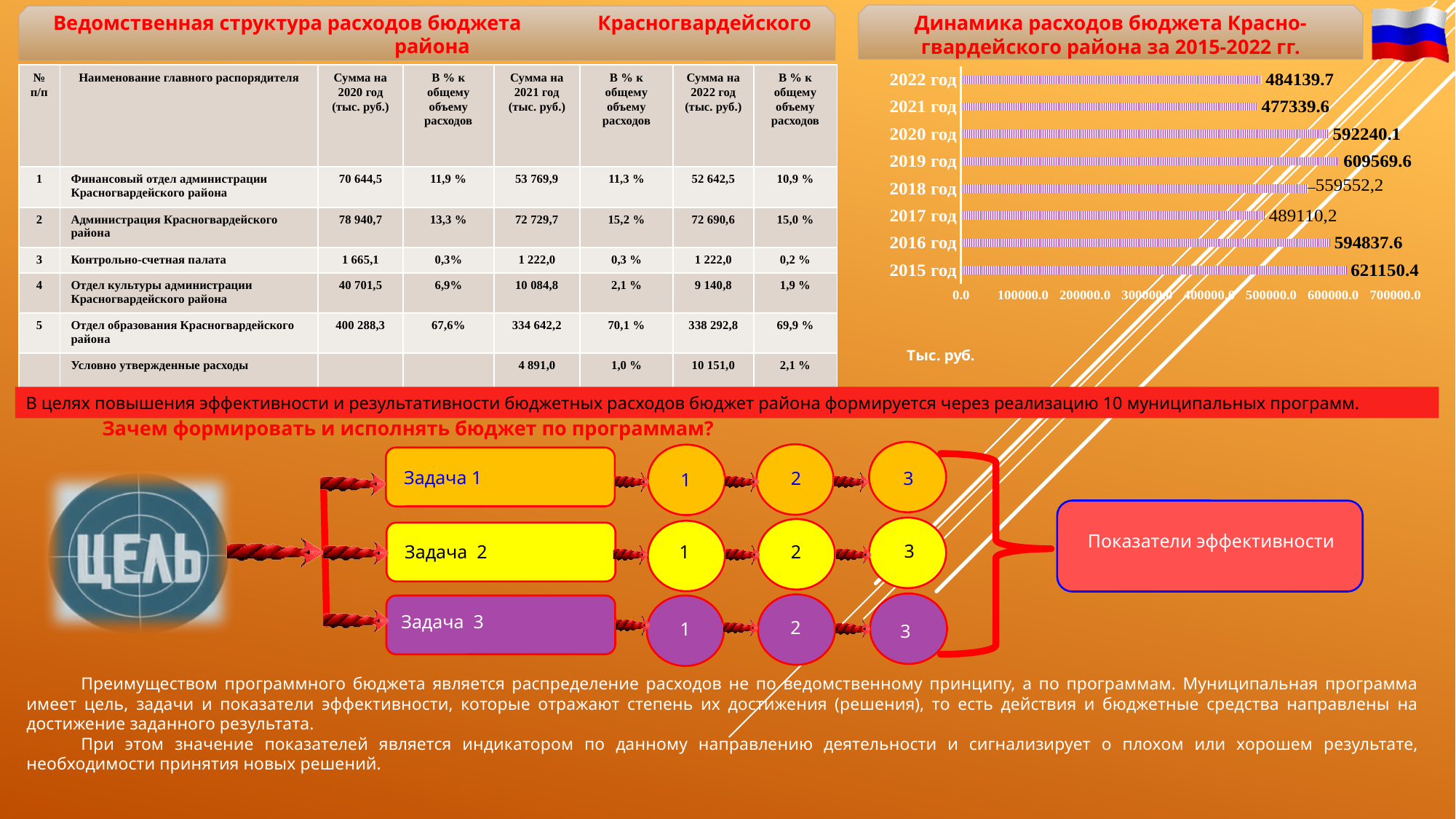
In the chart 'Динамика расходов бюджета Красногвардейского района за 2015-2022 гг.', do the values overall rise or fall from 2015 год to 2022 год? fall In the chart 'Динамика расходов бюджета Красногвардейского района за 2015-2022 гг.', what is the difference between the values for 2015 год and 2022 год? 137010.7 What unit is indicated below the chart 'Динамика расходов бюджета Красногвардейского района за 2015-2022 гг.'? Тыс. руб. In the chart 'Динамика расходов бюджета Красногвардейского района за 2015-2022 гг.', is the value for 2017 год greater or less than 500000.0? less What is the value for 2015 год in the chart 'Динамика расходов бюджета Красногвардейского района за 2015-2022 гг.'? 621150.4 How many years (bars) are shown in the chart 'Динамика расходов бюджета Красногвардейского района за 2015-2022 гг.'? 8 What kind of chart is 'Динамика расходов бюджета Красногвардейского района за 2015-2022 гг.'? bar chart Which year has the highest value in the chart 'Динамика расходов бюджета Красногвардейского района за 2015-2022 гг.'? 2015 год Which year has the lowest value in the chart 'Динамика расходов бюджета Красногвардейского района за 2015-2022 гг.'? 2021 год In the chart 'Динамика расходов бюджета Красногвардейского района за 2015-2022 гг.', which is larger: the value for 2019 год or 2020 год? 2019 год What is the value for 2018 год in the chart 'Динамика расходов бюджета Красногвардейского района за 2015-2022 гг.'? 559552,2 What is the value for 2021 год in the chart 'Динамика расходов бюджета Красногвардейского района за 2015-2022 гг.'? 477339.6